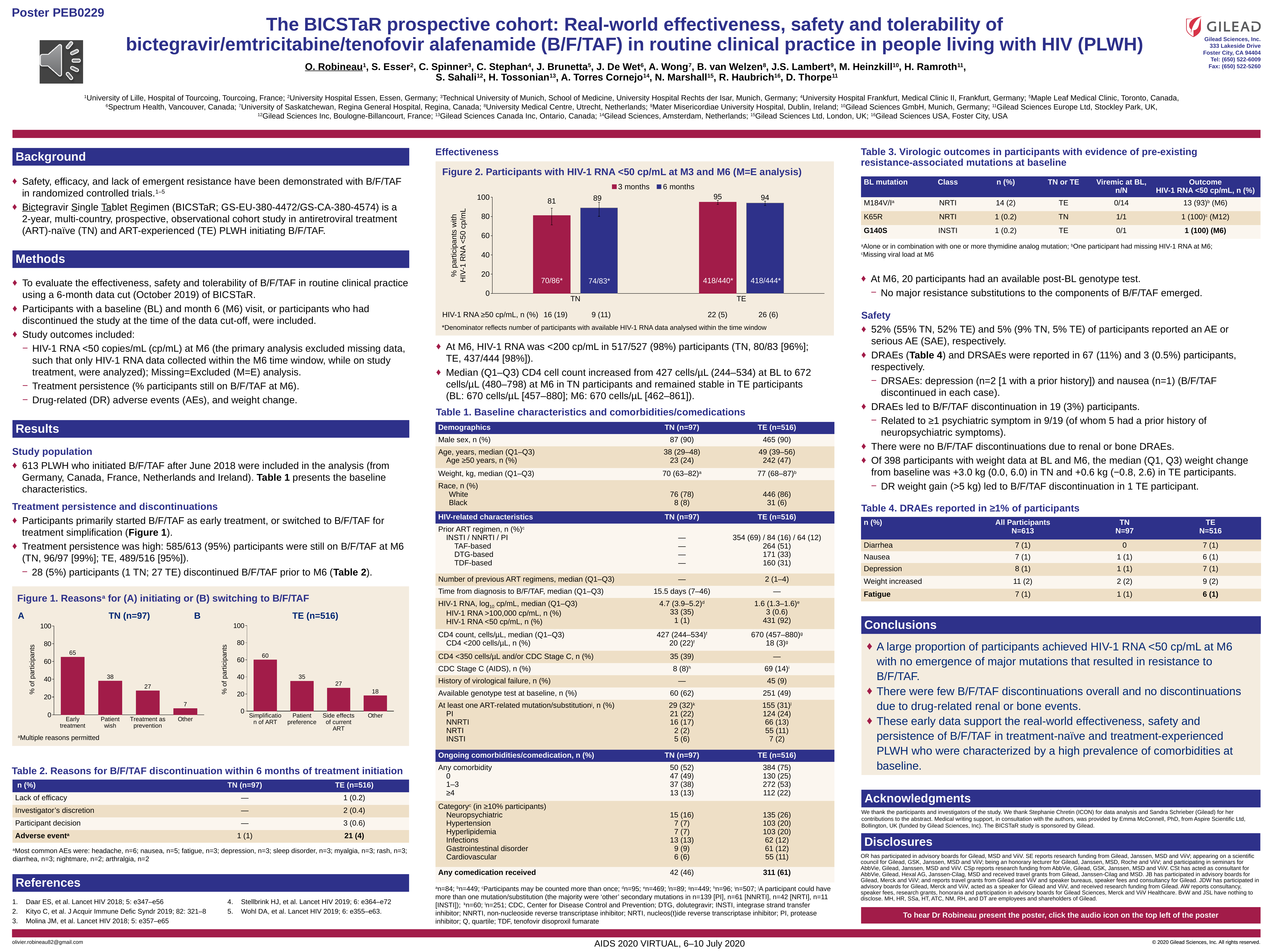
In Figure 1B (TE, n=516), which reason has the highest percentage of participants? Simplification of ART In Figure 1A (TN, n=97), what is the difference in percentage points between patient wish and treatment as prevention? 11 In Figure 2, what percentage of TE participants had HIV-1 RNA <50 cp/mL at 3 months? 95 In Figure 1A (TN, n=97), what percentage of participants cited early treatment as a reason for initiating B/F/TAF? 65 In Figure 1B (TE, n=516), what percentage of participants cited simplification of ART as a reason for switching? 60 In Figure 2, what percentage of TN participants had HIV-1 RNA <50 cp/mL at 6 months? 89 In Figure 1A (TN, n=97), which reason has the lowest percentage of participants? Other In Figure 1B (TE, n=516), which is larger: the percentage for patient preference or for side effects of current ART? Patient preference In Figure 1B (TE, n=516), how many reason categories are shown on the x axis? 4 In Figure 2, how many series does the legend list? 2 In Figure 2, what is the difference in percentage points between the 6-month and 3-month values for TN participants? 8 What type of chart is Figure 2? Bar chart